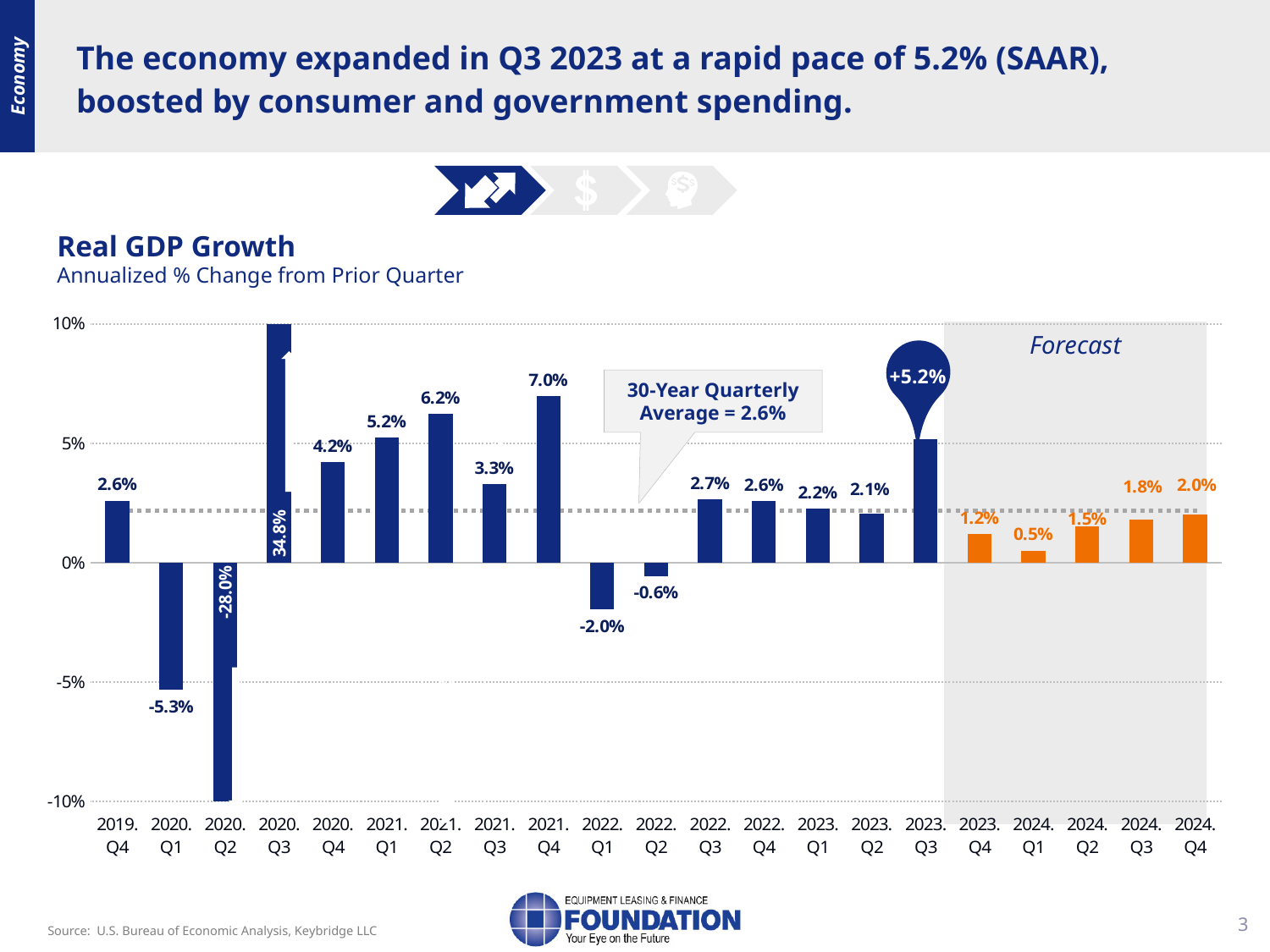
What is the 30-year quarterly average shown in the callout on the chart? 2.6% What is the subtitle of the Real GDP Growth chart? Annualized % Change from Prior Quarter Which is larger, the Real GDP Growth value for 2023 Q3 or for 2022 Q3? 2023 Q3 How many quarters are plotted in the Real GDP Growth chart? 21 Which quarter has the highest Real GDP Growth value? 2020 Q3 Do the forecast values rise or fall from 2024 Q1 to 2024 Q4? Rise What is the forecast Real GDP Growth value for 2024 Q1? 0.5% What is the Real GDP Growth value for 2020 Q3? 34.8% What is the Real GDP Growth value for 2020 Q2? -28.0% What kind of chart is used to show Real GDP Growth? Bar chart Which quarter has the lowest Real GDP Growth value? 2020 Q2 What is the difference between the Real GDP Growth values for 2021 Q4 and 2021 Q3? 3.7%